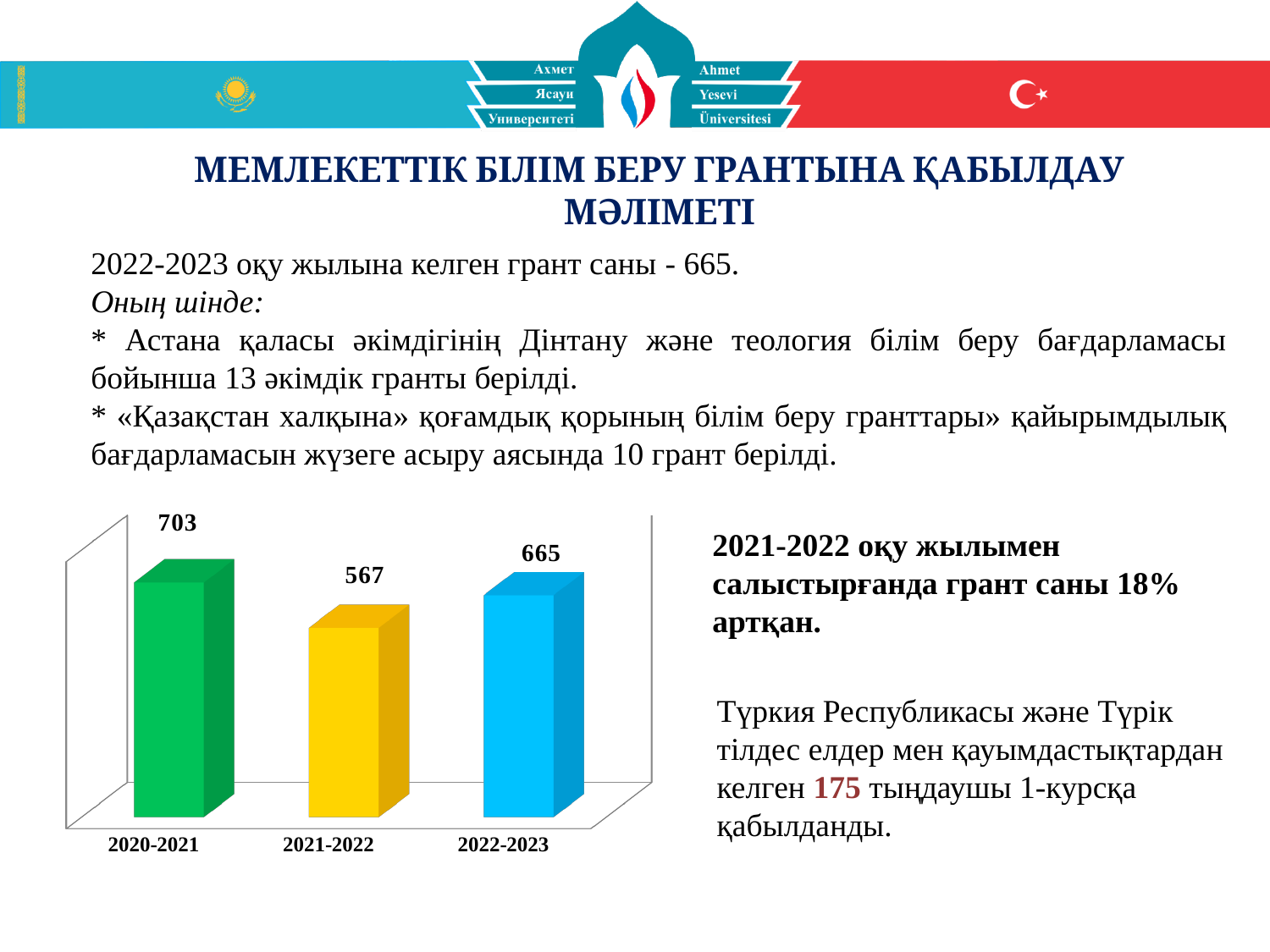
What is the value for 2020-2021? 703 What is the difference between the values for 2022-2023 and 2021-2022? 98 Which is larger, the value for 2021-2022 or the value for 2022-2023? 2022-2023 What colour is the bar for 2021-2022? yellow Which academic year has the highest value? 2020-2021 Which academic year has the lowest value? 2021-2022 What is the value for 2021-2022? 567 What kind of chart is shown on the slide? bar chart Does the value rise or fall from 2021-2022 to 2022-2023? rise What is the difference between the values for 2020-2021 and 2022-2023? 38 How many academic years are shown in the chart? 3 What is the value for 2022-2023? 665